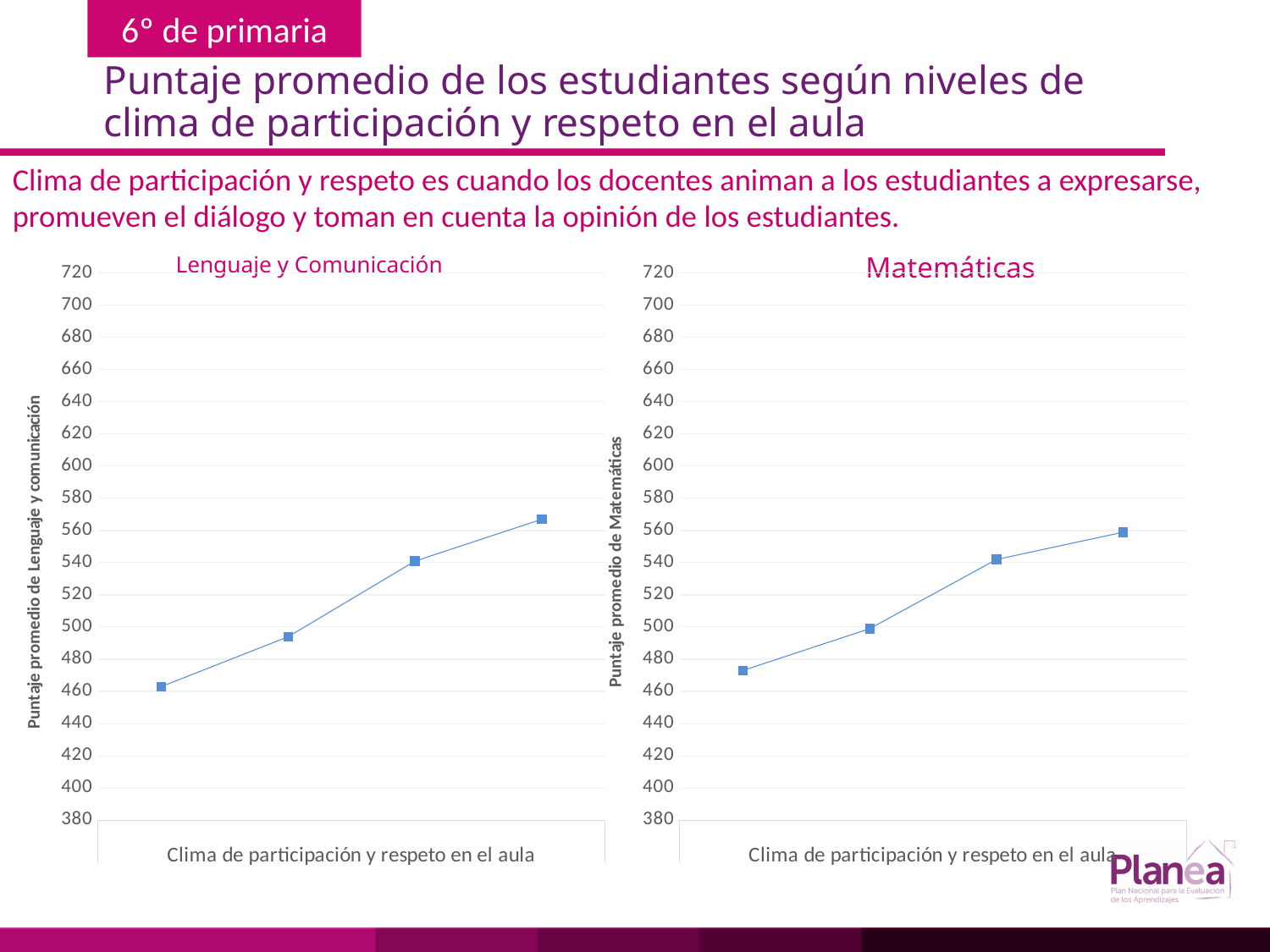
In the Lenguaje y Comunicación chart, is the value of the rightmost point greater or less than 560? greater How many data points are plotted in the Matemáticas chart? 4 What is the title of the vertical axis in the Matemáticas chart? Puntaje promedio de Matemáticas In the Lenguaje y Comunicación chart, do the values rise or fall from left to right? rise What kind of chart is the Lenguaje y Comunicación chart? line chart In the Lenguaje y Comunicación chart, is the value of the leftmost point greater or less than 480? less In the Matemáticas chart, is the value of the second point from the left greater or less than 520? less What is the horizontal axis label in the Lenguaje y Comunicación chart? Clima de participación y respeto en el aula In the Matemáticas chart, which point is highest, the leftmost or the rightmost? rightmost In the Matemáticas chart, do the values rise or fall from left to right? rise